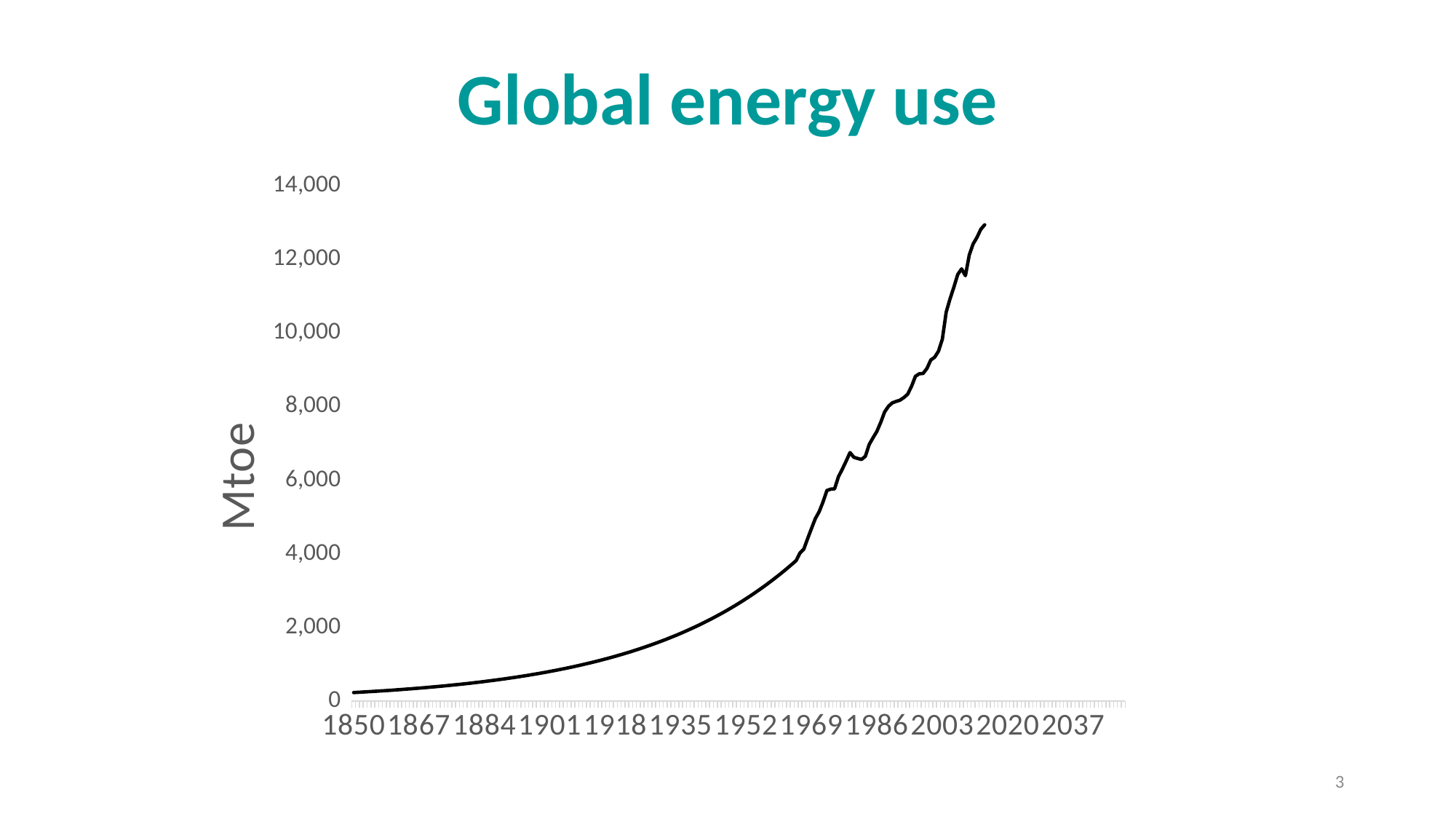
What kind of chart is shown on the slide? line chart Is the value for 1986 greater or less than 4,000? greater Is the value for 1850 greater or less than 2,000? less Is the highest value on the line greater or less than 14,000? less What is the label on the vertical axis of the chart? Mtoe Do the values rise or fall along the x axis from 1850 to 2020? rise What is the first year labelled on the x axis? 1850 What is the title of the chart? Global energy use How many lines are plotted on the chart? 1